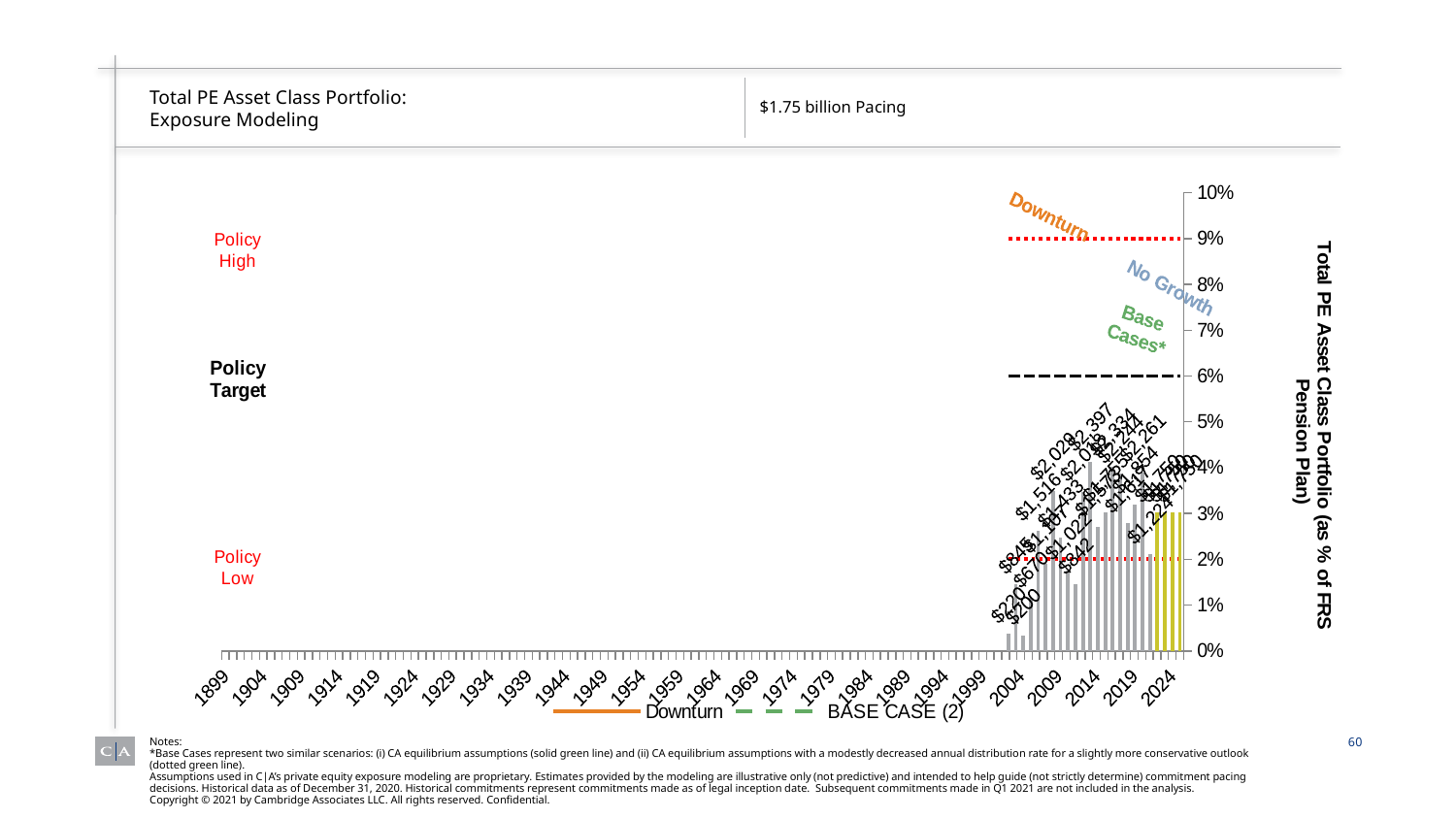
At what percentage is the Policy High line drawn? 9% How many series does the legend at the bottom of the chart list? 2 What is the last year label on the x axis? 2024 At what percentage is the Policy Low line drawn? 2% Which is higher, the Policy Target line or the Policy Low line? Policy Target What is the difference between the Policy High level and the Policy Target level? 3% At what percentage is the Policy Target line drawn? 6% What is the first year label on the x axis? 1899 What is the highest value shown on the percentage axis? 10% What kind of chart is shown on the slide? combination bar and line chart What is the difference between the Policy High level and the Policy Low level? 7%